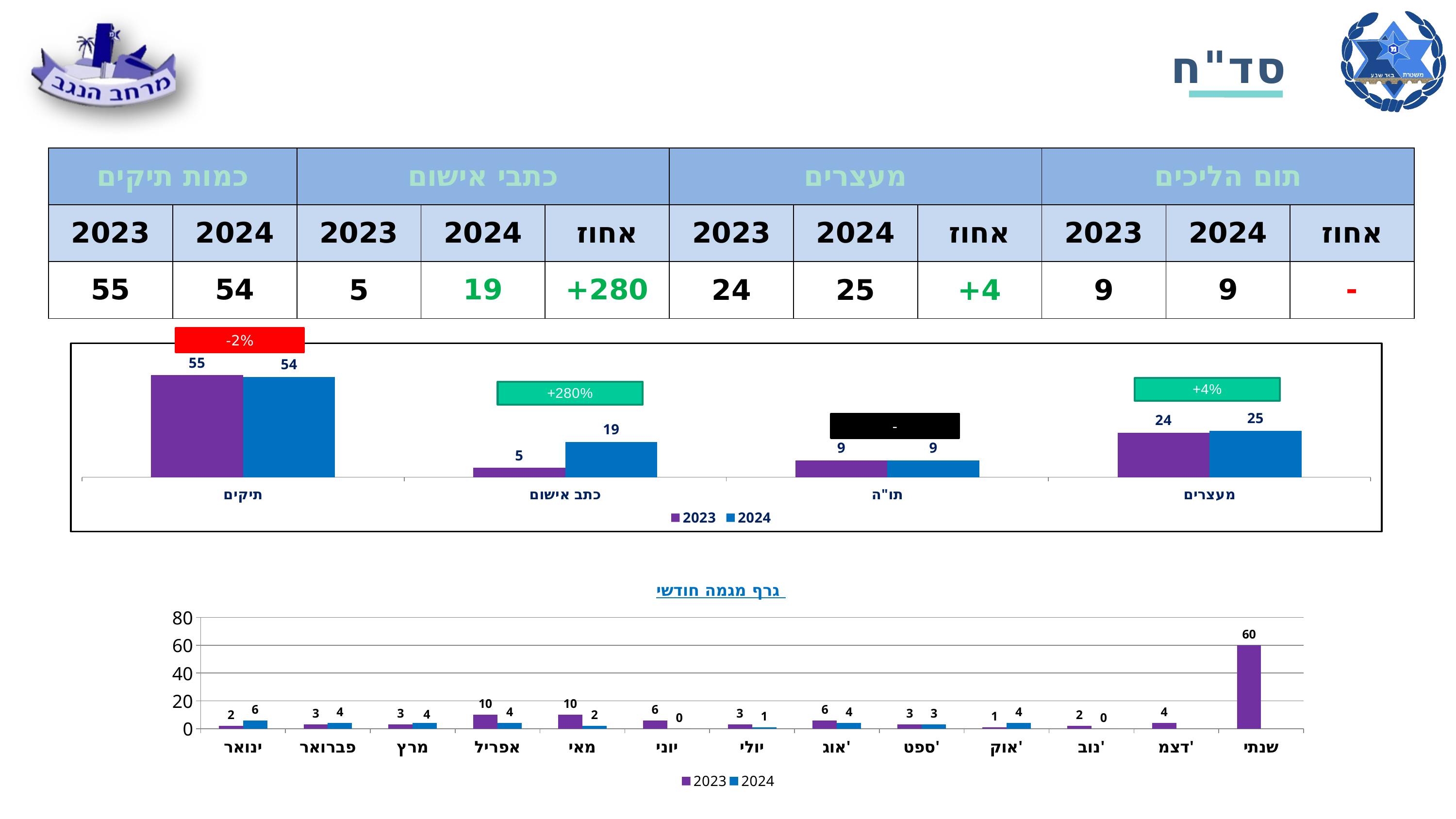
In the upper chart, what is the 2023 value for מעצרים? 24 In the chart titled גרף מגמה חודשי, is the 2023 value for שנתי greater or less than 40? greater In the upper chart, what is the 2024 value for כתב אישום? 19 In the chart titled גרף מגמה חודשי, what is the 2023 value for אפריל? 10 What kind of chart is the chart titled גרף מגמה חודשי? bar chart In the upper chart, what percentage change label is shown above the תיקים bars? -2% In the upper chart, what is the difference between the 2024 and 2023 values for כתב אישום? 14 In the chart titled גרף מגמה חודשי, which is larger: the 2023 value for מאי or the 2024 value for מאי? 2023 In the chart titled גרף מגמה חודשי, what is the 2024 value for ינואר? 6 In the upper chart, which category has the highest 2023 value? תיקים In the upper chart, how many series does the legend list? 2 In the chart titled גרף מגמה חודשי, which category has the highest 2023 value? שנתי